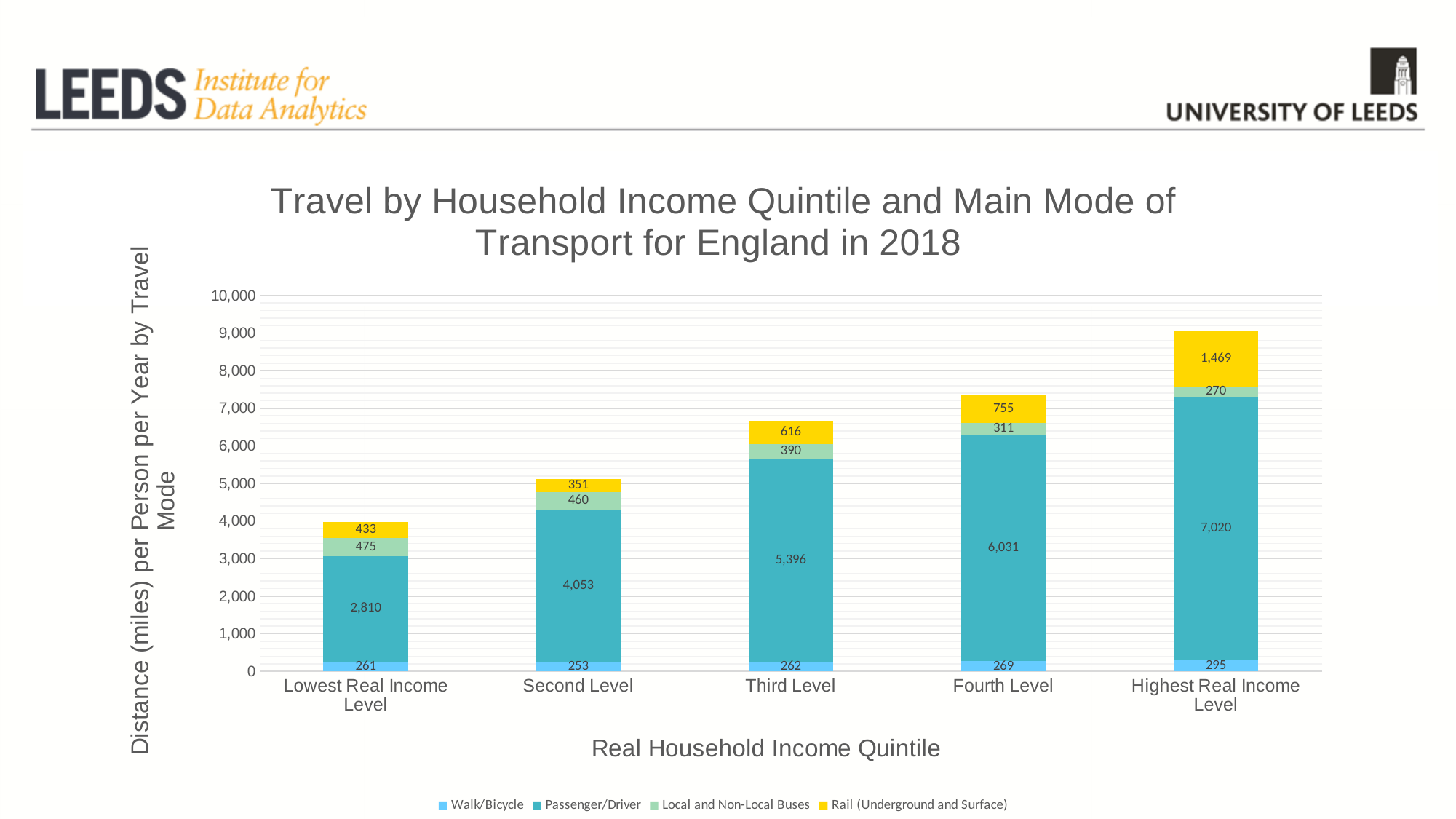
Which is larger: the Local and Non-Local Buses value for the Lowest Real Income Level or for the Fourth Level? Lowest Real Income Level Which income quintile has the lowest Walk/Bicycle value? Second Level Is the total stacked bar for the Fourth Level greater or less than 7,000? greater How many series does the legend list? 4 What kind of chart is shown on the slide? Stacked bar chart Which income quintile has the highest Rail (Underground and Surface) value? Highest Real Income Level What is the Rail (Underground and Surface) value for the Highest Real Income Level? 1,469 What is the total of the stacked bar for the Lowest Real Income Level? 3,979 How many income quintile categories are shown on the x axis? 5 What is the Local and Non-Local Buses value for the Second Level? 460 What is the difference between the Passenger/Driver values for the Highest Real Income Level and the Lowest Real Income Level? 4,210 What is the Passenger/Driver value for the Third Level income quintile? 5,396